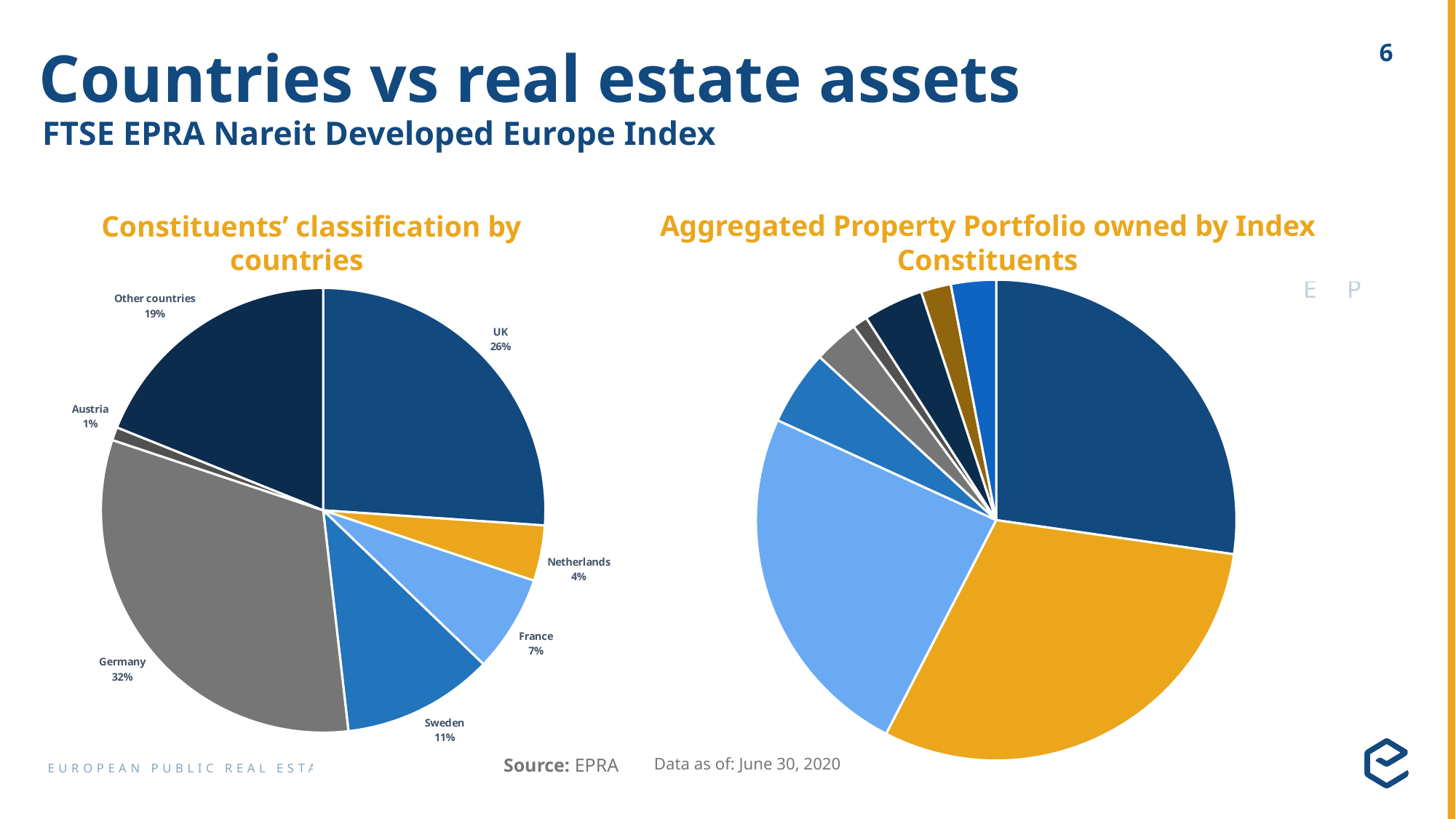
In the 'Constituents' classification by countries' chart, what share does Sweden have? 11% In the 'Constituents' classification by countries' chart, what share do Other countries have? 19% What is the title of the chart on the left of the slide? Constituents' classification by countries In the 'Constituents' classification by countries' chart, what share does France have? 7% In the 'Constituents' classification by countries' chart, how many percentage points larger is Germany's share than the UK's? 6 percentage points In the 'Constituents' classification by countries' chart, what share does the UK have? 26% In the 'Constituents' classification by countries' chart, which country has the smallest share? Austria In the 'Constituents' classification by countries' chart, which country has the largest share? Germany What type of chart is the 'Aggregated Property Portfolio owned by Index Constituents' chart? Pie chart How many slices does the 'Constituents' classification by countries' pie chart have? 7 In the 'Constituents' classification by countries' chart, which has the larger share, Sweden or France? Sweden In the 'Constituents' classification by countries' chart, what share does Germany have? 32%